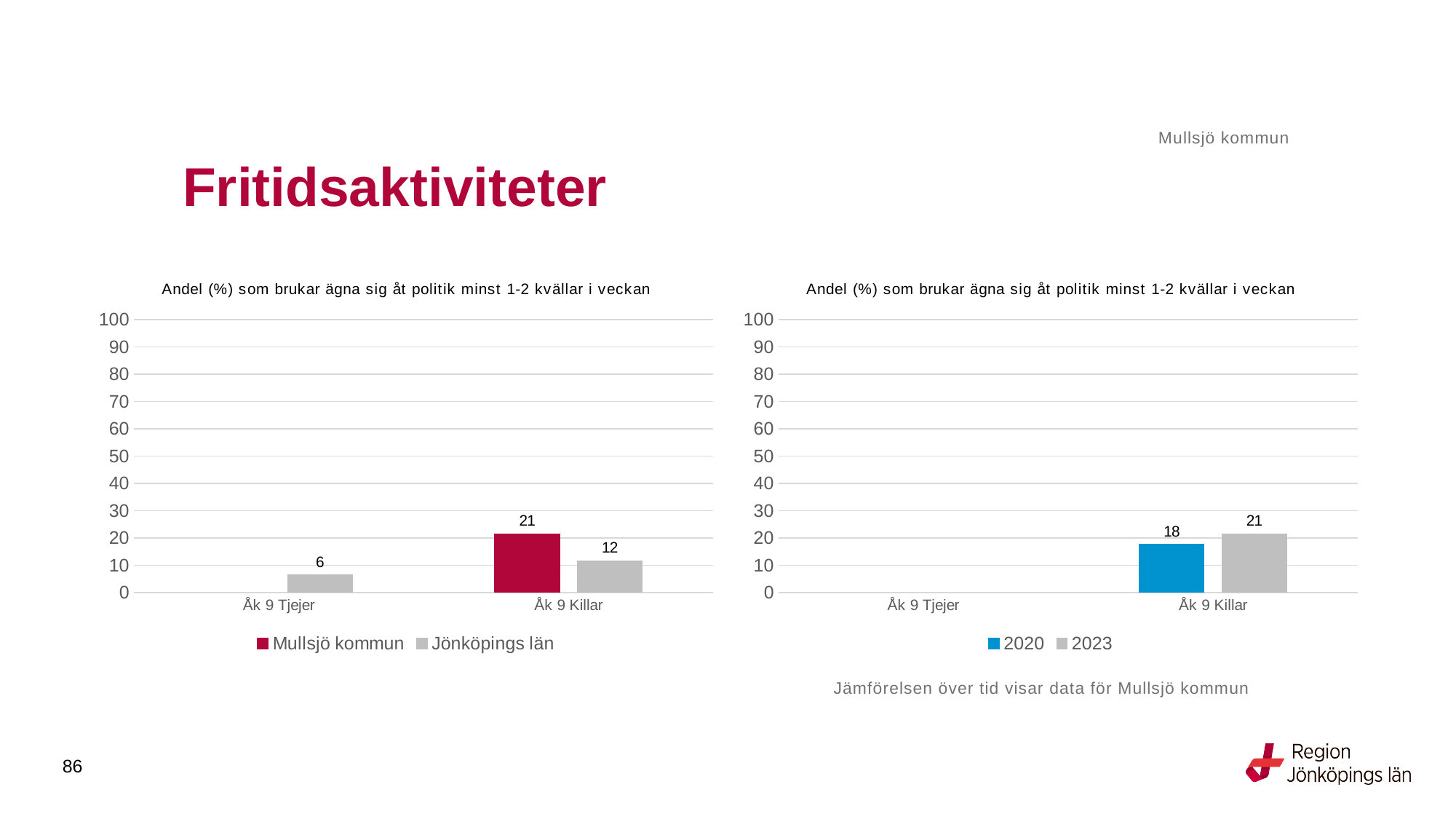
In the right chart, which year has the higher value for Åk 9 Killar: 2020 or 2023? 2023 In the left chart, what is the value for Jönköpings län for Åk 9 Killar? 12 In the right chart, what is the value for 2020 for Åk 9 Killar? 18 In the left chart, which is larger for Åk 9 Killar: Mullsjö kommun or Jönköpings län? Mullsjö kommun In the left chart, what is the value for Jönköpings län for Åk 9 Tjejer? 6 In the left chart, what is the value for Mullsjö kommun for Åk 9 Killar? 21 In the left chart, what is the difference between Mullsjö kommun and Jönköpings län for Åk 9 Killar? 9 In the right chart, what is the value for 2023 for Åk 9 Killar? 21 How many series does the legend of the right chart list? 2 What kind of chart is the left chart? Bar chart In the right chart, what is the difference between the 2023 and 2020 values for Åk 9 Killar? 3 What are the two series listed in the legend of the left chart? Mullsjö kommun and Jönköpings län